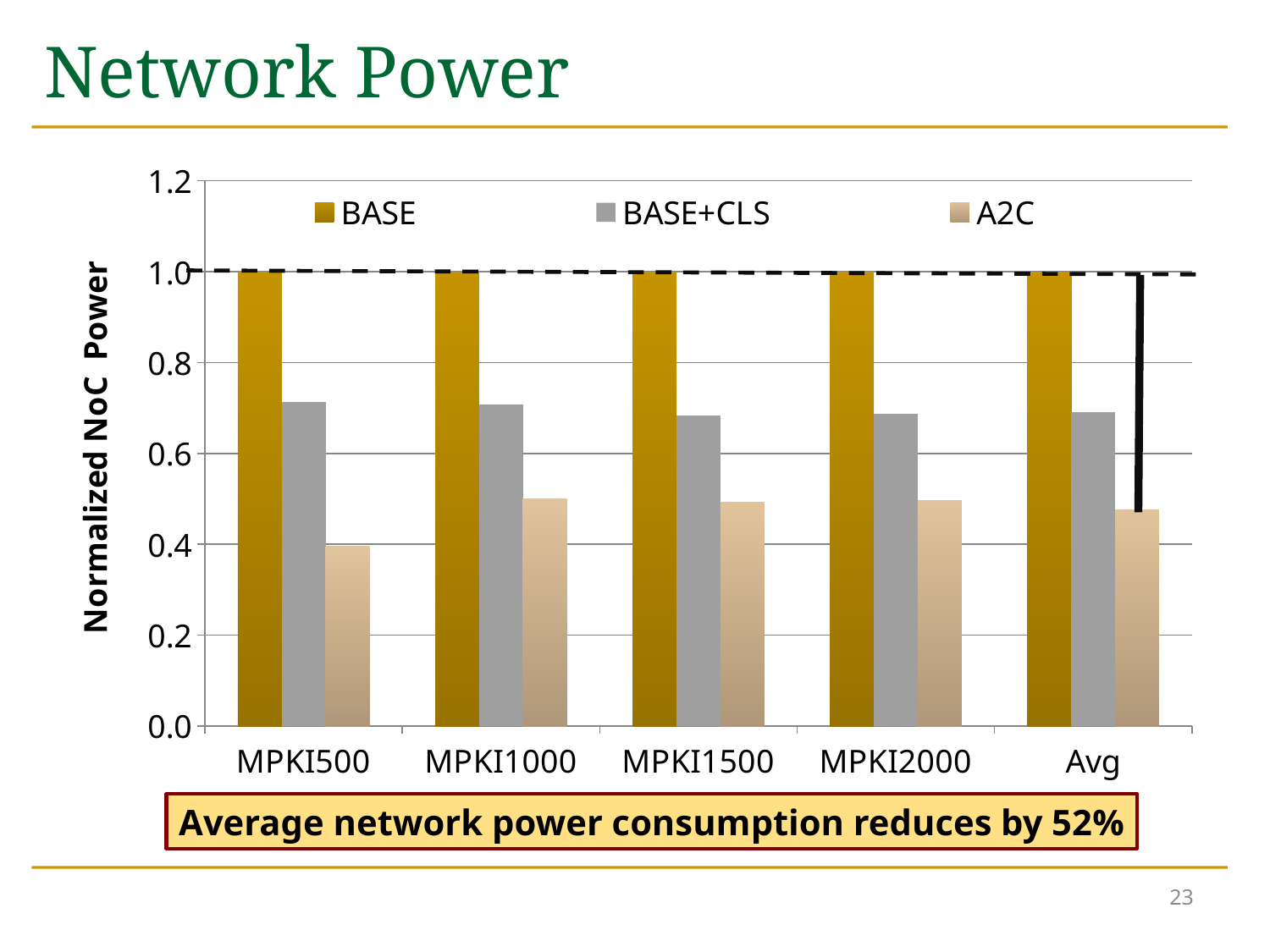
What is the value of BASE for MPKI500? 1.0 Is the value of BASE+CLS for MPKI2000 greater or less than 0.6? greater For which category is the A2C value lowest? MPKI500 Is the value of A2C for Avg greater or less than 0.6? less How many categories are shown on the x axis? 5 What is the y-axis label of the chart? Normalized NoC Power What kind of chart is shown on the slide? bar chart How many series does the legend list? 3 Is the value of BASE+CLS for MPKI500 greater or less than 0.8? less What is the value of BASE for Avg? 1.0 For MPKI1500, which is larger: BASE+CLS or A2C? BASE+CLS